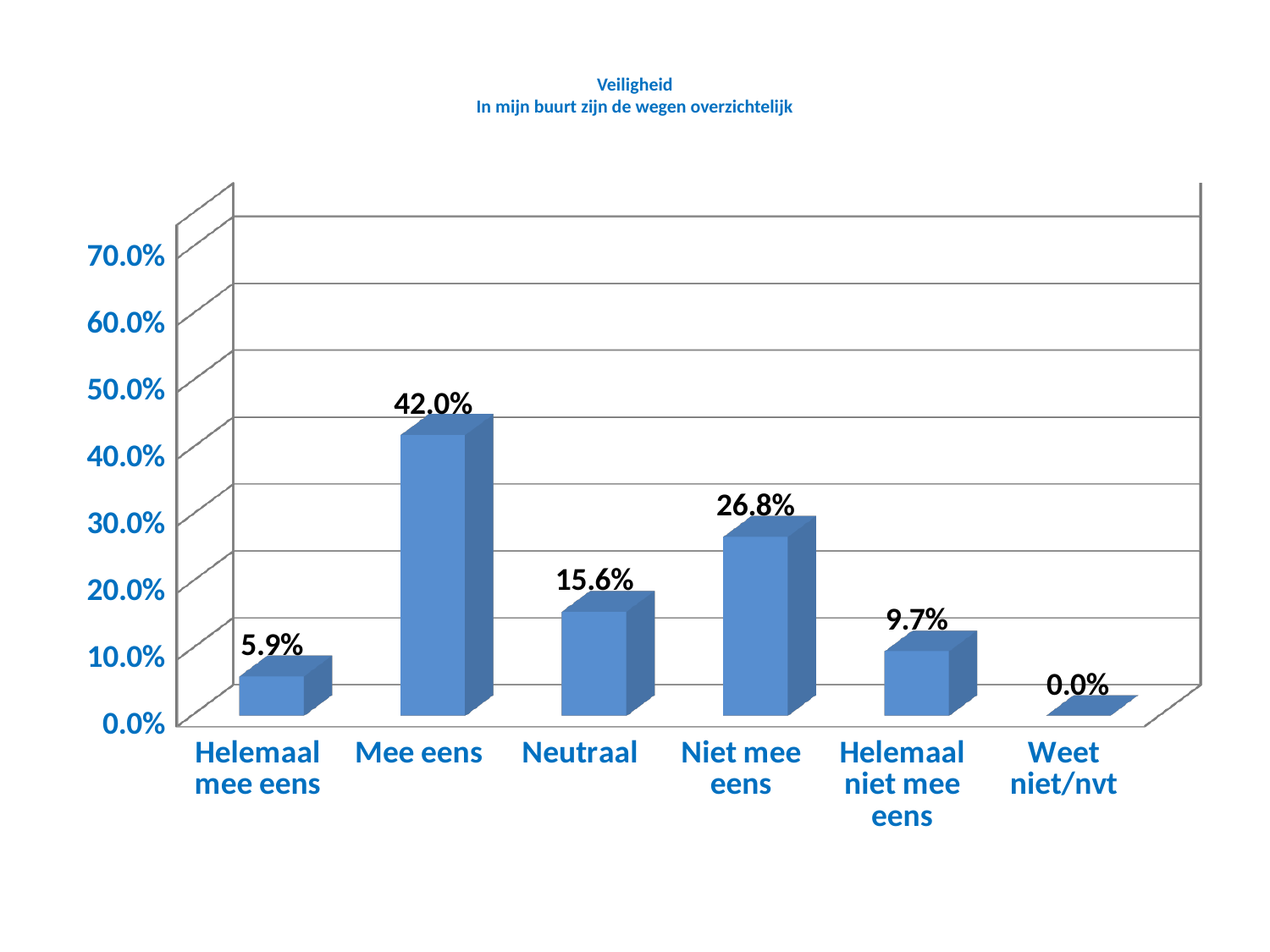
What is the value for "Helemaal mee eens"? 5.9% Which category has the lowest value? Weet niet/nvt Which category has the highest value? Mee eens What is the value for "Niet mee eens"? 26.8% What is the value for "Mee eens"? 42.0% Is the value for "Niet mee eens" greater or less than 20.0%? greater What is the title of the chart? Veiligheid In mijn buurt zijn de wegen overzichtelijk Which is larger, the value for "Neutraal" or the value for "Helemaal niet mee eens"? Neutraal What is the difference between the values for "Mee eens" and "Niet mee eens"? 15.2% What kind of chart is shown on the slide? bar chart How many categories are shown on the x axis? 6 What is the value for "Weet niet/nvt"? 0.0%